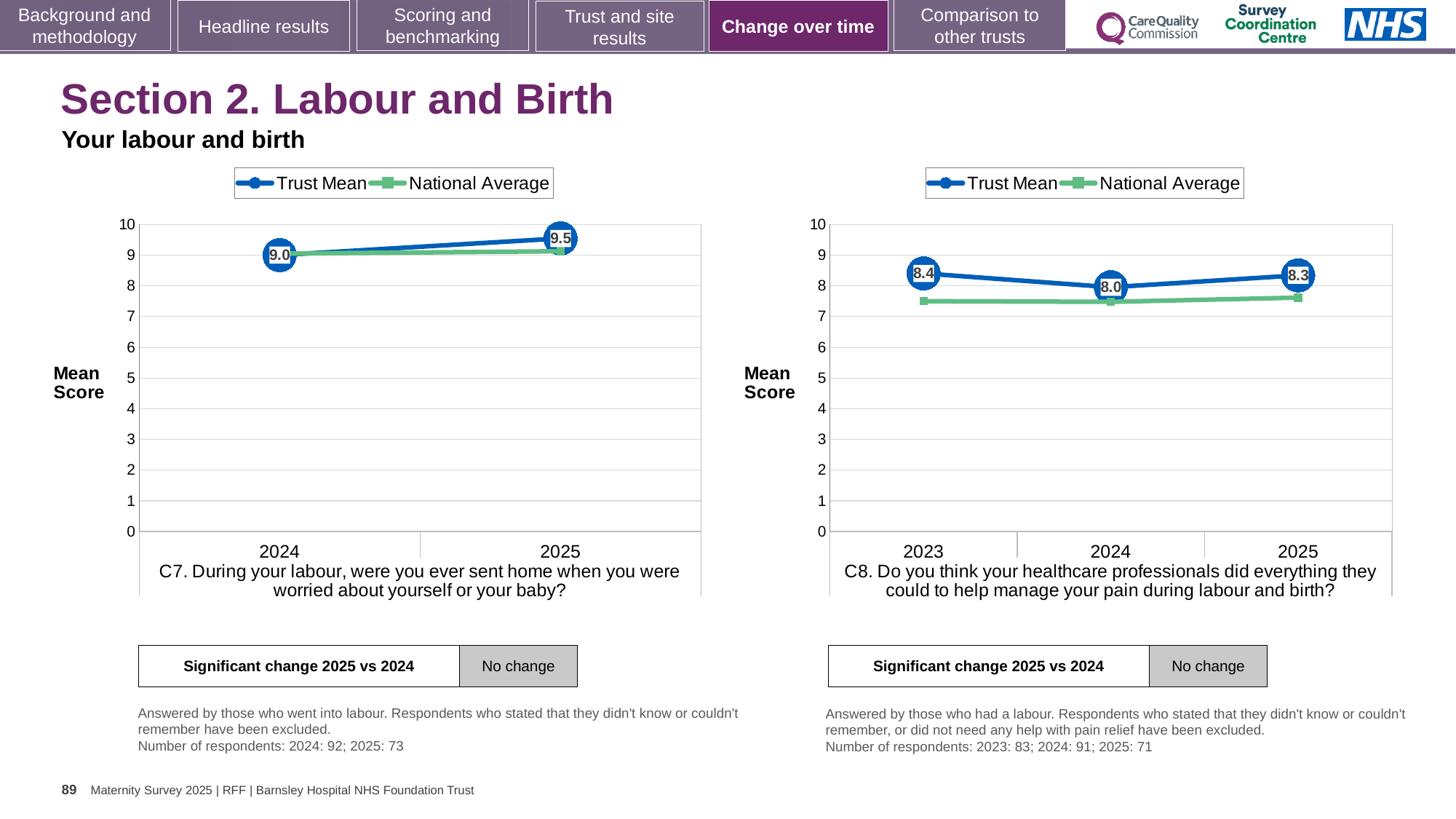
In the C8 chart (right), how many years are shown on the x axis? 3 What type of chart is the C8 chart (right)? line chart In the C7 chart (left), what is the Trust Mean for 2024? 9.0 In the C7 chart (left), what is the Trust Mean for 2025? 9.5 In the C8 chart (right), which year has the lowest Trust Mean? 2024 How many series does the legend of the C7 chart (left) list? 2 In the C7 chart (left), by how much did the Trust Mean change from 2024 to 2025? 0.5 In the C8 chart (right), what is the Trust Mean for 2024? 8.0 In the C8 chart (right), is the National Average for 2024 greater or less than 8? less In the C8 chart (right), what is the difference between the Trust Mean in 2023 and 2025? 0.1 In the C8 chart (right), which year has the highest Trust Mean? 2023 In the C7 chart (left), does the Trust Mean rise or fall from 2024 to 2025? rise